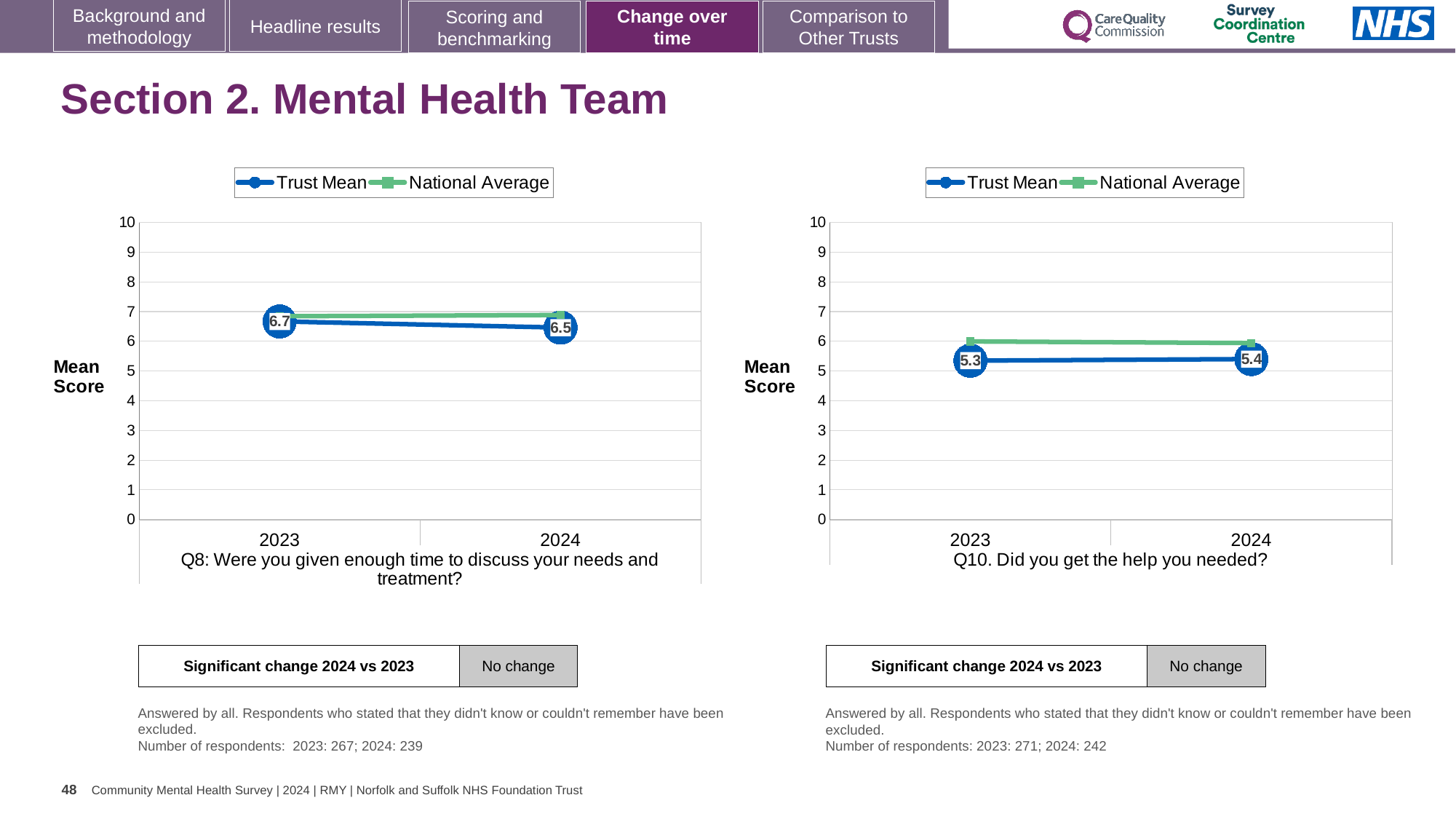
In the Q8 chart (left), by how much did the Trust Mean change from 2023 to 2024? 0.2 In the Q8 chart (left), what is the Trust Mean for 2024? 6.5 In the Q8 chart (left), does the Trust Mean rise or fall from 2023 to 2024? fall In the Q10 chart (right), in 2024 which series is higher, Trust Mean or National Average? National Average How many series does the legend of the Q10 chart (right) list? 2 In the Q10 chart (right), does the Trust Mean rise or fall from 2023 to 2024? rise What kind of chart is the Q8 chart (left)? line chart In the Q10 chart (right), what is the Trust Mean for 2024? 5.4 In the Q10 chart (right), what is the Trust Mean for 2023? 5.3 In the Q8 chart (left), what is the Trust Mean for 2023? 6.7 In the Q8 chart (left), which year has the higher Trust Mean, 2023 or 2024? 2023 In the Q8 chart (left), is the National Average for 2023 greater or less than 6? greater